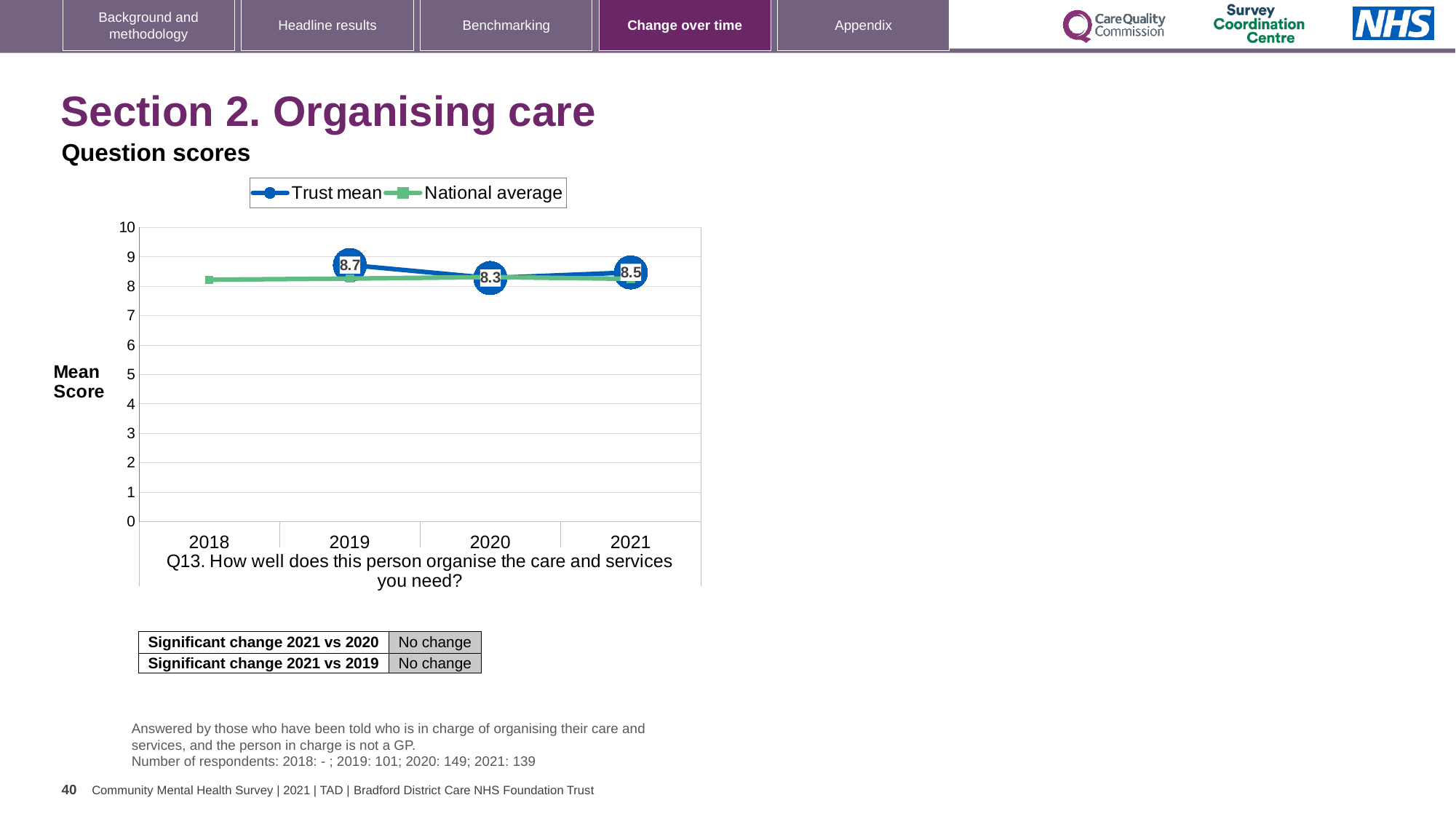
How many series does the legend list? 2 Is the National average for 2018 greater or less than 5? greater How many years are shown on the x axis? 4 In which year is the Trust mean lowest? 2020 What is the difference between the Trust mean in 2019 and in 2020? 0.4 What kind of chart is shown? Line chart What is the Trust mean for 2019? 8.7 Which is larger, the Trust mean in 2021 or the Trust mean in 2020? 2021 In which year is the Trust mean highest? 2019 Does the Trust mean rise or fall from 2019 to 2020? Fall What is the Trust mean for 2021? 8.5 What is the Trust mean for 2020? 8.3